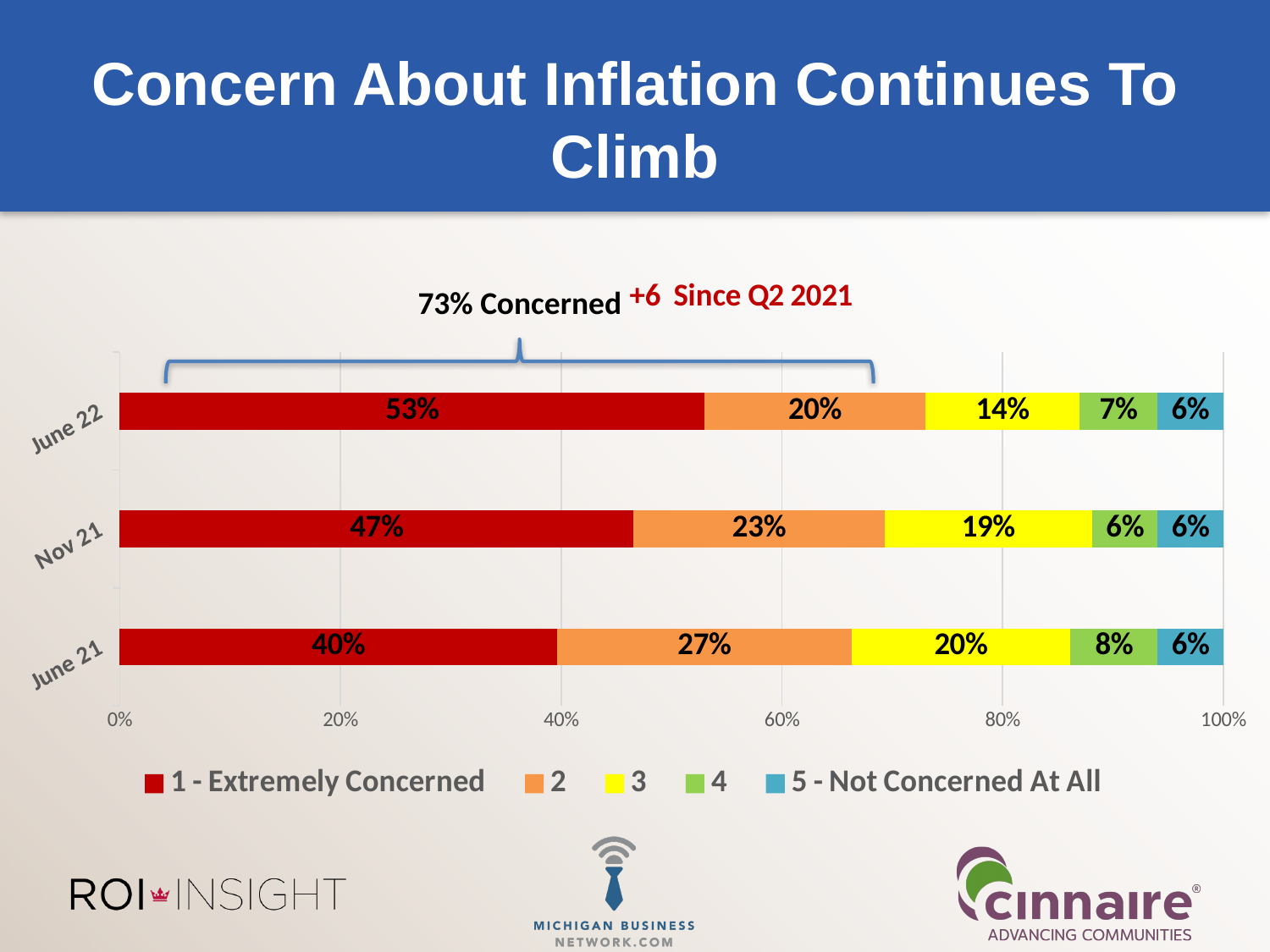
Which period has the lowest share of '1 - Extremely Concerned' respondents? June 21 What is the value for category '3' in the Nov 21 bar? 19% Which is larger: the '3' share in June 21 or the '3' share in June 22? June 21 What is the combined share of '1 - Extremely Concerned' and '2' in the Nov 21 bar? 70% What kind of chart is shown on the slide? Stacked bar chart How many time periods are shown on the chart? 3 What percentage of respondents were '1 - Extremely Concerned' in June 22? 53% How many series does the legend list? 5 Which period has the highest share of '1 - Extremely Concerned' respondents? June 22 By how many percentage points did the '1 - Extremely Concerned' share change from June 21 to June 22? 13 What is the value for '2' in the June 21 bar? 27% What is the value for '5 - Not Concerned At All' in June 22? 6%